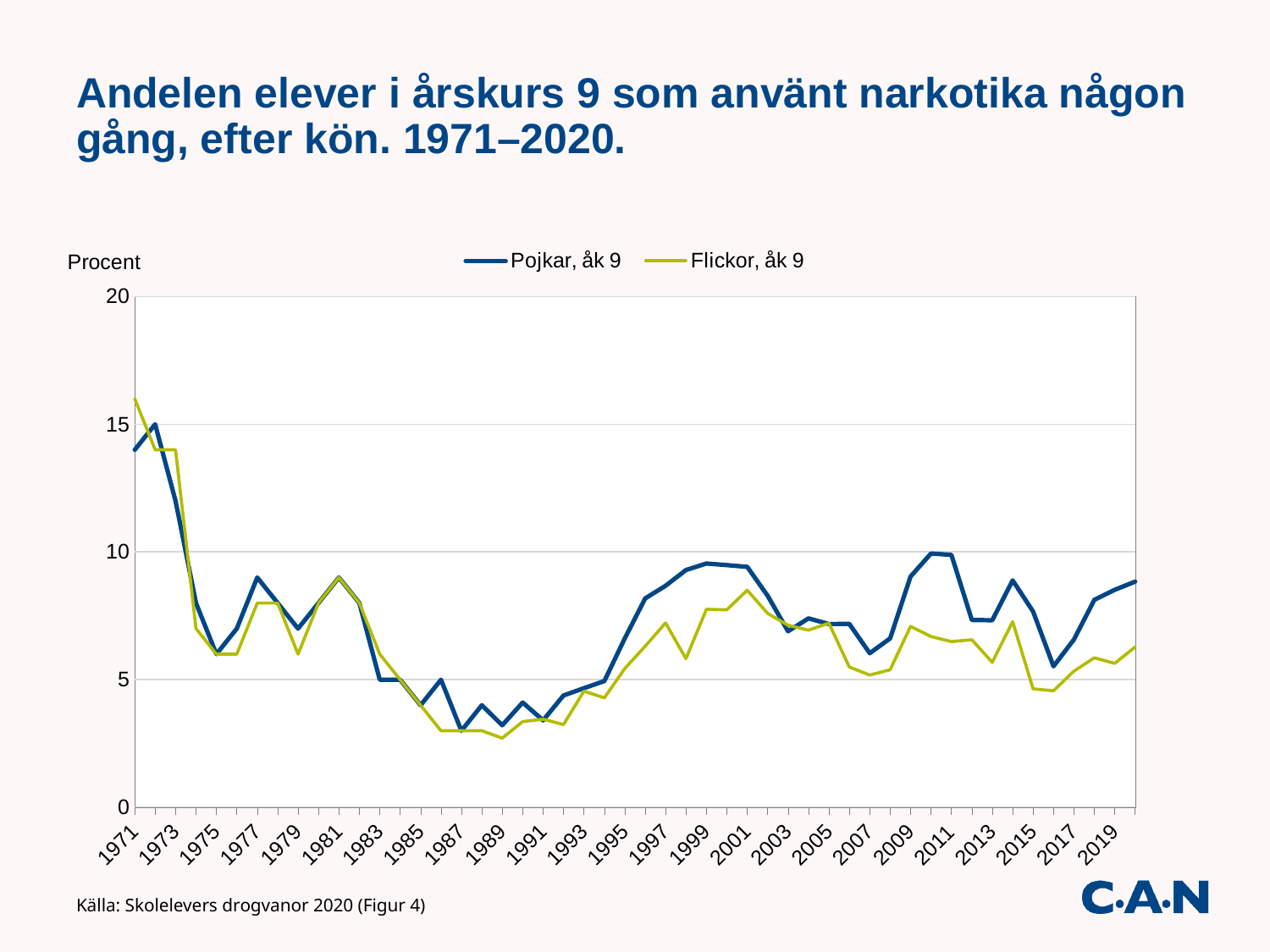
Do the values for Pojkar, åk 9 rise or fall between 1971 and 1975? fall What kind of chart is shown on the slide? line chart How many series does the legend list? 2 Is the value for Pojkar, åk 9 in 1989 greater or less than 5? less Is the value for Flickor, åk 9 in 2015 greater or less than 5? less What is the label on the vertical axis? Procent What are the two series named in the legend? Pojkar, åk 9 and Flickor, åk 9 Is the value for Pojkar, åk 9 in 1971 greater or less than 15? less In 1971, which series has the higher value, Pojkar, åk 9 or Flickor, åk 9? Flickor, åk 9 In 2011, which series has the higher value, Pojkar, åk 9 or Flickor, åk 9? Pojkar, åk 9